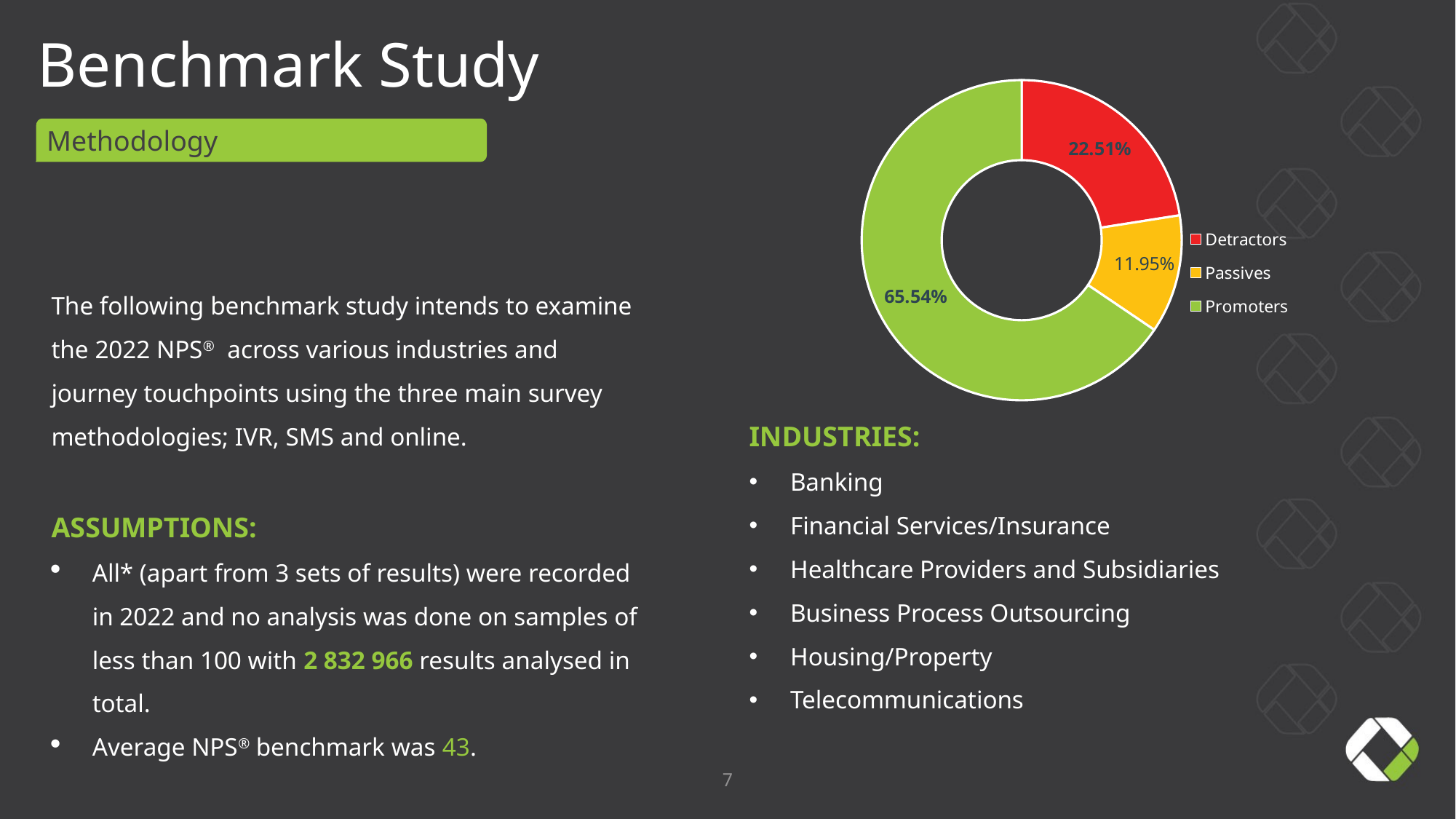
What colour represents Detractors in the chart? Red What percentage of the doughnut chart is Promoters? 65.54% What kind of chart is shown on the slide? Doughnut chart Which is larger, the Detractors share or the Passives share? Detractors How many categories does the doughnut chart show? 3 Which category has the smallest share of the doughnut chart? Passives What colour represents Passives in the chart? Yellow What percentage of the doughnut chart is Detractors? 22.51% What percentage of the doughnut chart is Passives? 11.95% What is the difference in percentage points between Detractors and Passives? 10.56 Which category has the largest share of the doughnut chart? Promoters What is the difference in percentage points between Promoters and Detractors? 43.03